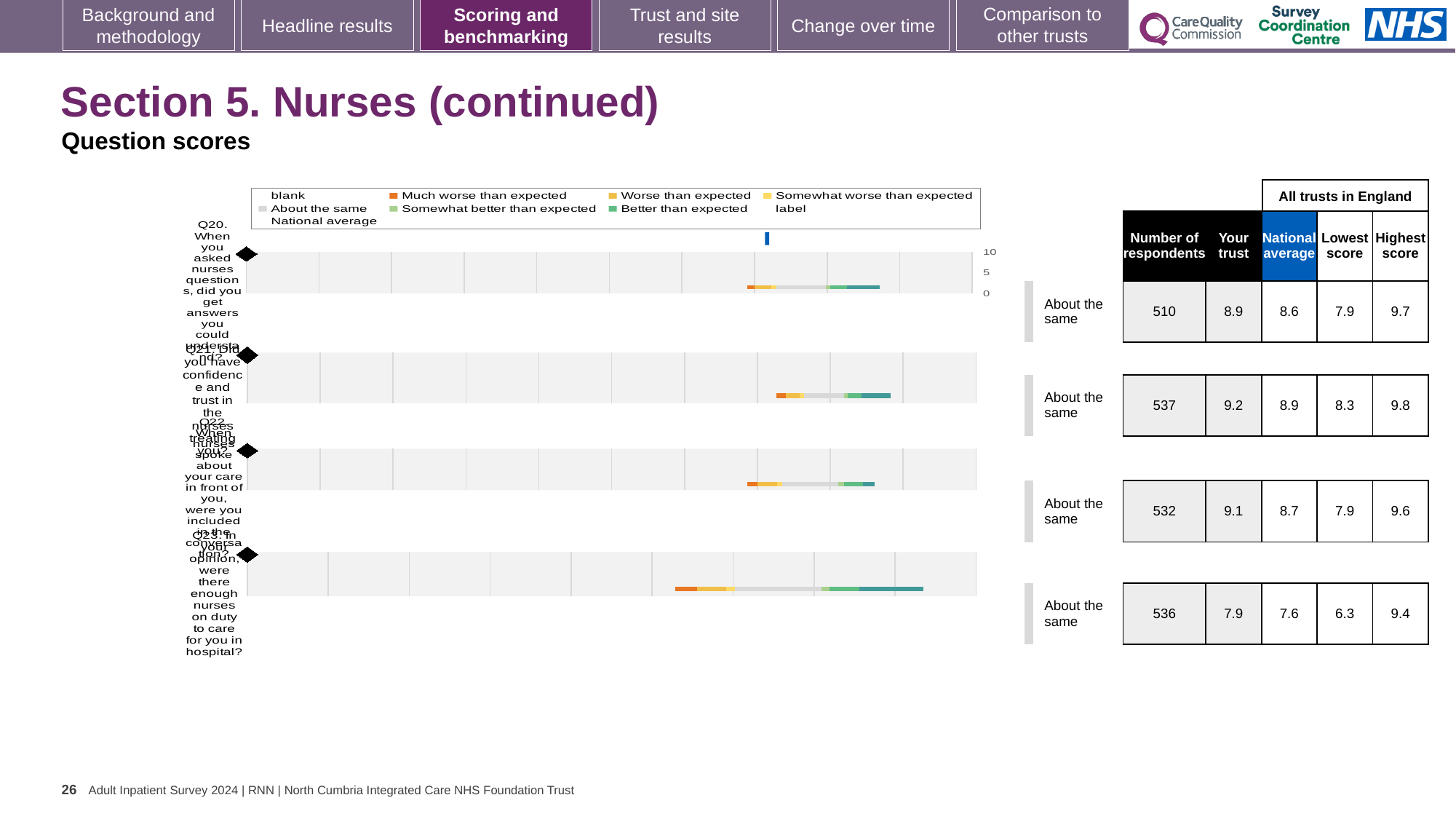
For the Q23 chart (enough nurses on duty), what is the national average score? 7.6 For the Q23 chart, what is the lowest score among all trusts in England? 6.3 Which question has the lowest 'Your trust' score? Q23 For the Q22 chart, which is larger: the 'Your trust' score or the national average? Your trust How many question charts (Q20 to Q23) are shown on the slide? 4 For the Q21 chart (confidence and trust in nurses), what is the 'Your trust' score? 9.2 What kind of chart is used for each question on the slide? bar chart For the Q20 chart, what is the difference between the 'Your trust' score and the national average? 0.3 For the Q22 chart, how many respondents are there? 532 For the Q21 chart, what is the highest score among all trusts in England? 9.8 Which question has the highest 'Your trust' score? Q21 Which question has the largest number of respondents? Q21